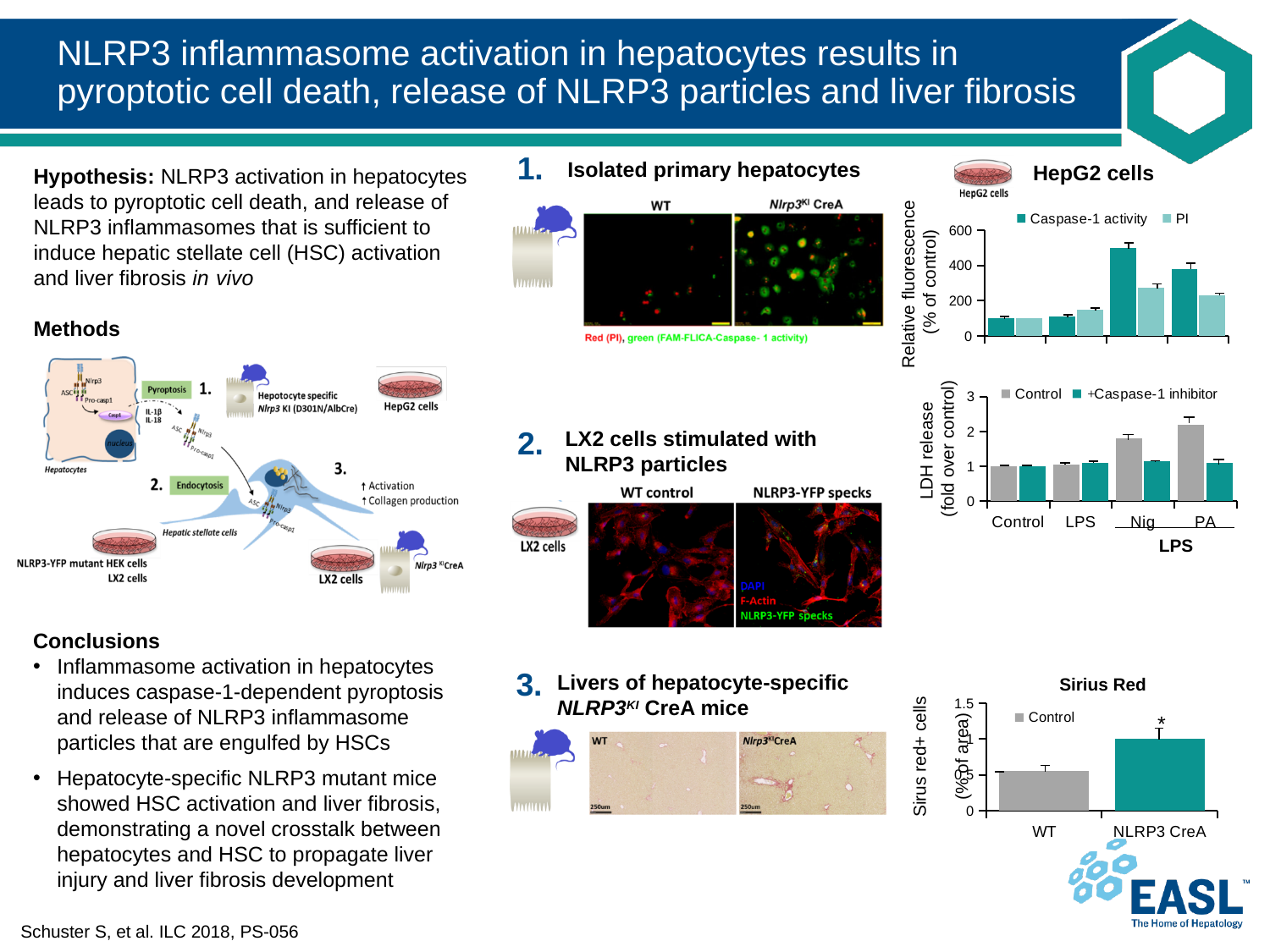
How many categories are shown on the x axis of the 'Sirius Red' chart? 2 In the LDH release chart, is the Control value for Nig greater or less than 2? less In the LDH release chart, for PA, which series is larger: Control or +Caspase-1 inhibitor? Control In the 'HepG2 cells' relative fluorescence chart, what are the two series listed in the legend? Caspase-1 activity and PI In the 'Sirius Red' chart, is the value for WT greater or less than 1? less What kind of chart is the 'Sirius Red' chart? bar chart What is the y-axis label of the 'Sirius Red' chart? Sirus red+ cells (% of area) In the 'Sirius Red' chart, is the value for NLRP3 CreA greater or less than 0.5? greater In the 'Sirius Red' chart, which category has the higher value, WT or NLRP3 CreA? NLRP3 CreA In the LDH release chart, how many series does the legend list? 2 In the LDH release chart, how many categories are shown on the x axis? 4 In the LDH release chart, which category has the highest Control value? PA